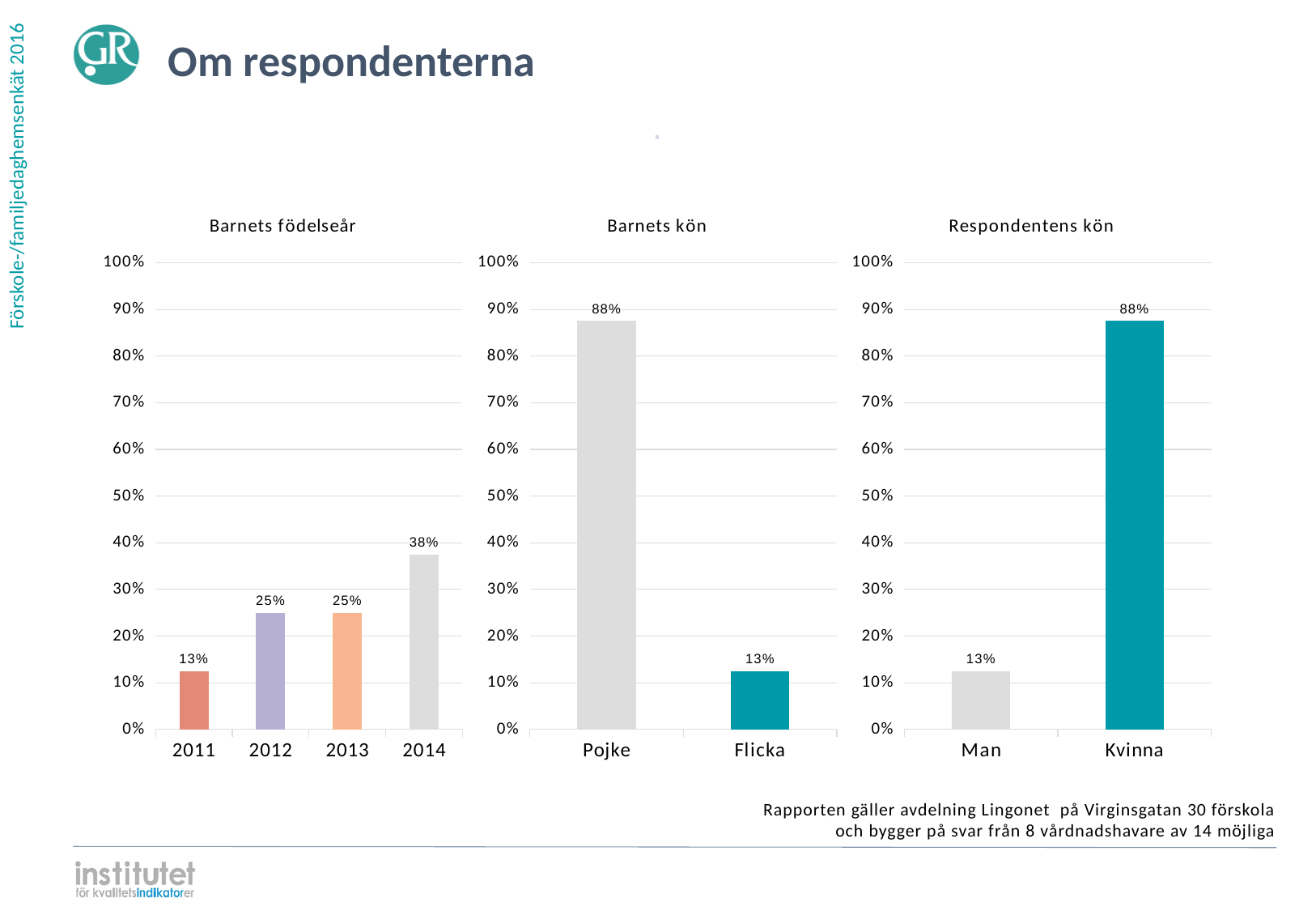
In the 'Barnets födelseår' chart, what is the value for 2011? 13% In the 'Barnets födelseår' chart, what is the difference between the values for 2014 and 2012? 13% In the 'Barnets födelseår' chart, how many birth-year categories are shown? 4 In the 'Barnets födelseår' chart, what is the value for 2014? 38% In the 'Barnets födelseår' chart, which birth year has the lowest value? 2011 In the 'Barnets kön' chart, which category is larger, Pojke or Flicka? Pojke In the 'Barnets födelseår' chart, which birth year has the highest value? 2014 In the 'Respondentens kön' chart, is the value for Kvinna greater or less than 80%? greater In the 'Respondentens kön' chart, what is the value for Man? 13% What kind of chart is the 'Barnets kön' chart? Bar chart In the 'Respondentens kön' chart, what is the difference between the values for Kvinna and Man? 75% In the 'Barnets kön' chart, what is the value for Pojke? 88%